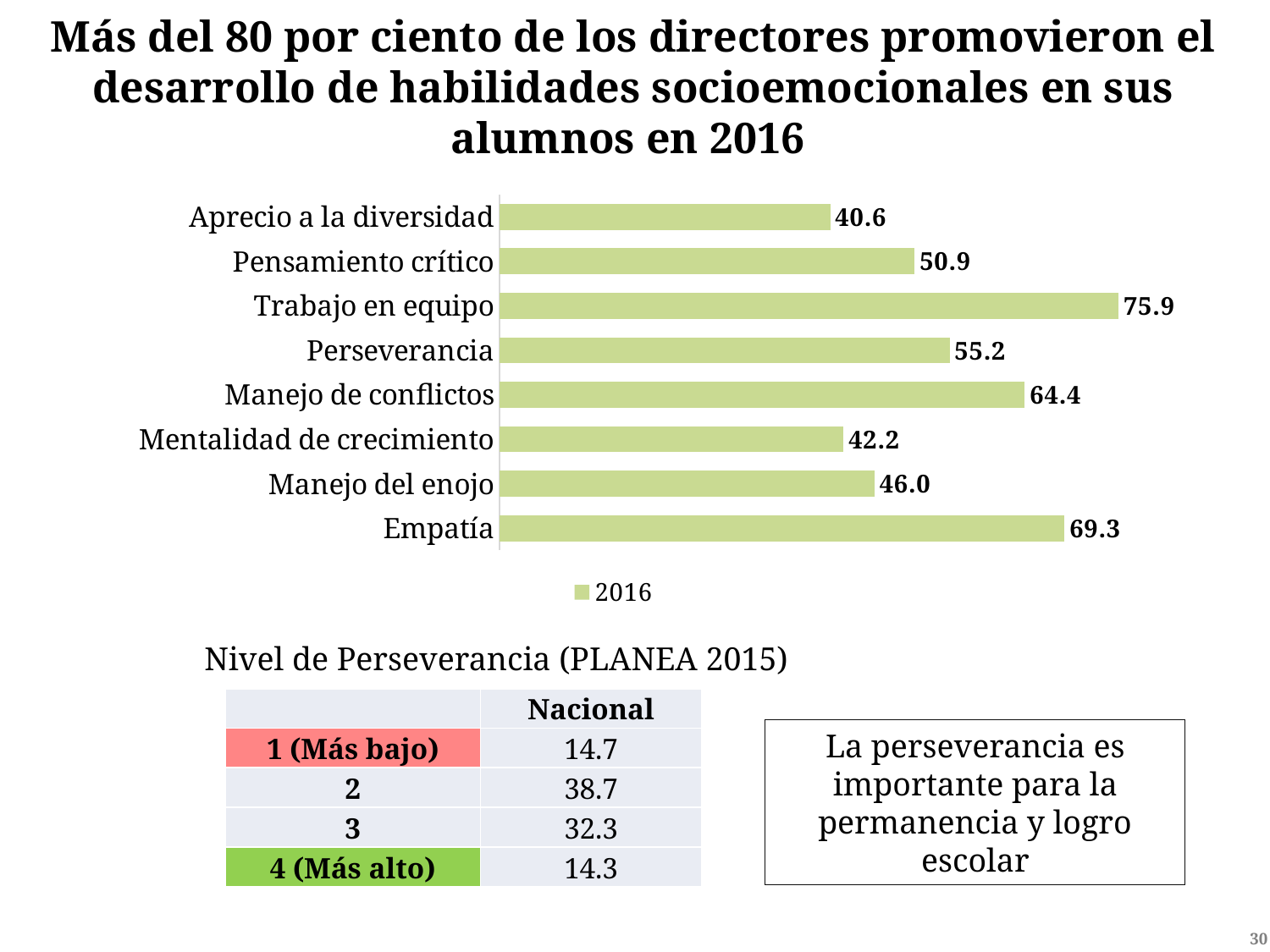
Which is larger, the value for Pensamiento crítico or the value for Manejo del enojo? Pensamiento crítico What is the difference between the values for Manejo de conflictos and Perseverancia? 9.2 Which category has the highest value? Trabajo en equipo What is the difference between the values for Trabajo en equipo and Aprecio a la diversidad? 35.3 What is the value for Mentalidad de crecimiento? 42.2 What is the value for Empatía? 69.3 What is the value for Manejo del enojo? 46.0 How many series does the legend list? 1 What kind of chart is shown on the slide? Bar chart What is the value for Trabajo en equipo? 75.9 How many categories are shown in the bar chart? 8 Which category has the lowest value? Aprecio a la diversidad